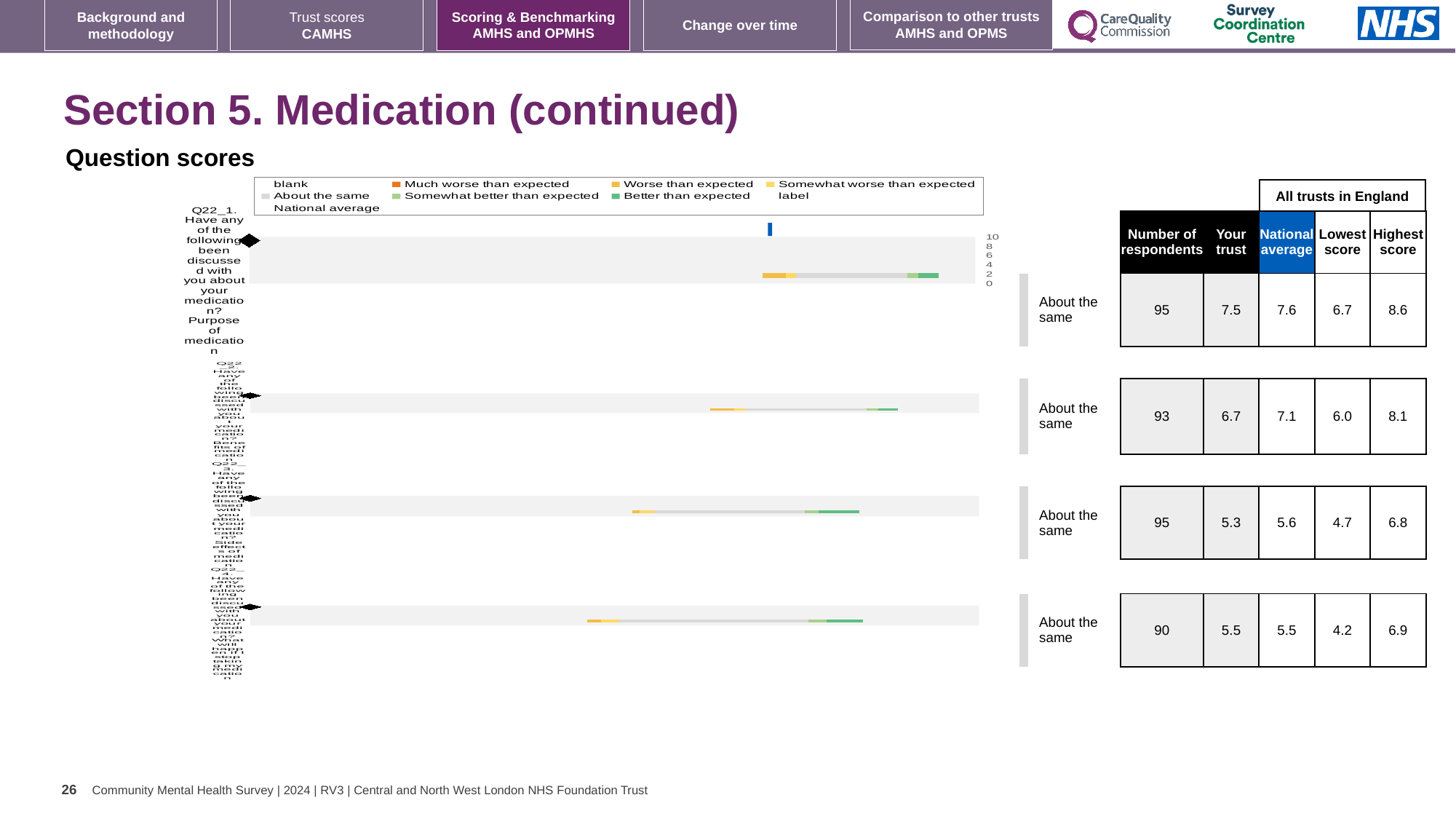
Which legend entry is shown in dark green? Better than expected What is the highest tick value shown on the chart's axis? 10 In the table next to the chart, what is the 'Your trust' score for the first row (Q22_1, Purpose of medication)? 7.5 In the table next to the chart, what is the difference between the highest score and lowest score for the third row (Q22_3)? 2.1 In the table next to the chart, which row has the highest 'Your trust' score? Q22_1 (Purpose of medication) In the table next to the chart, what is the number of respondents for the fourth row (Q22_4)? 90 What kind of chart is shown under 'Question scores'? bar chart How many bars (questions) are plotted in the chart? 4 In the table next to the chart, which row has the lowest 'Your trust' score? Q22_3 (Side effects of medication) In the table next to the chart, what is the national average for the second row (Q22_2, Benefits of medication)? 7.1 How many entries does the chart legend list? 9 In the table next to the chart, is the 'Your trust' score for the second row (Q22_2) larger or smaller than its national average? smaller